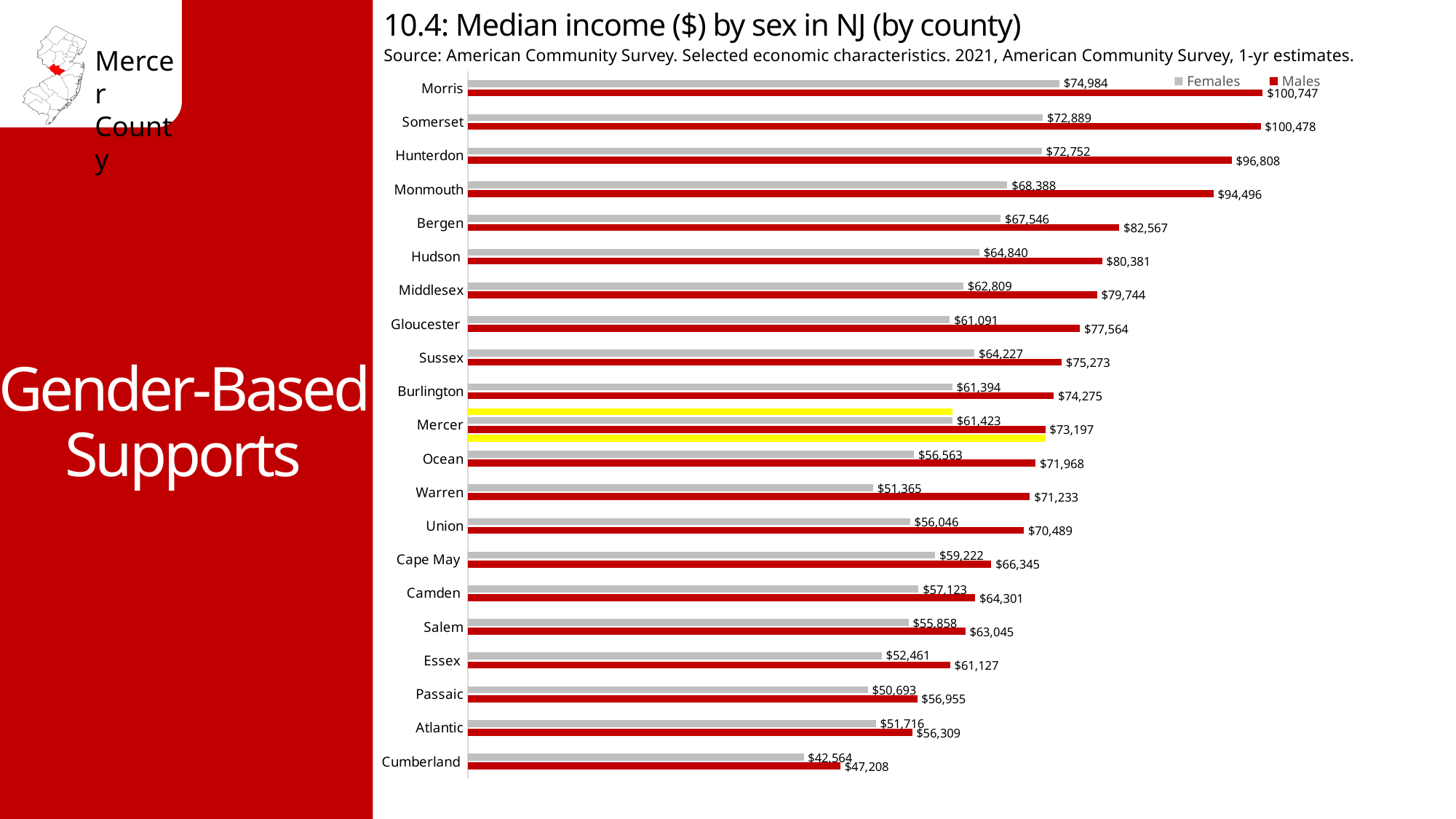
What is the median income for females in Mercer County? $61,423 Which county has the lowest median income for females? Cumberland Which county has the highest median income for males? Morris What is the median income for males in Mercer County? $73,197 How many counties are shown in the chart? 21 What is the difference between male and female median income in Mercer County? $11,774 What is the median income for females in Morris County? $74,984 What kind of chart is shown on the slide? Bar chart Which county's bars are highlighted in yellow on the chart? Mercer What is the difference between the male median income in Morris County and in Somerset County? $269 Which is larger: the female median income in Sussex County or in Gloucester County? Sussex How many series does the legend list? 2